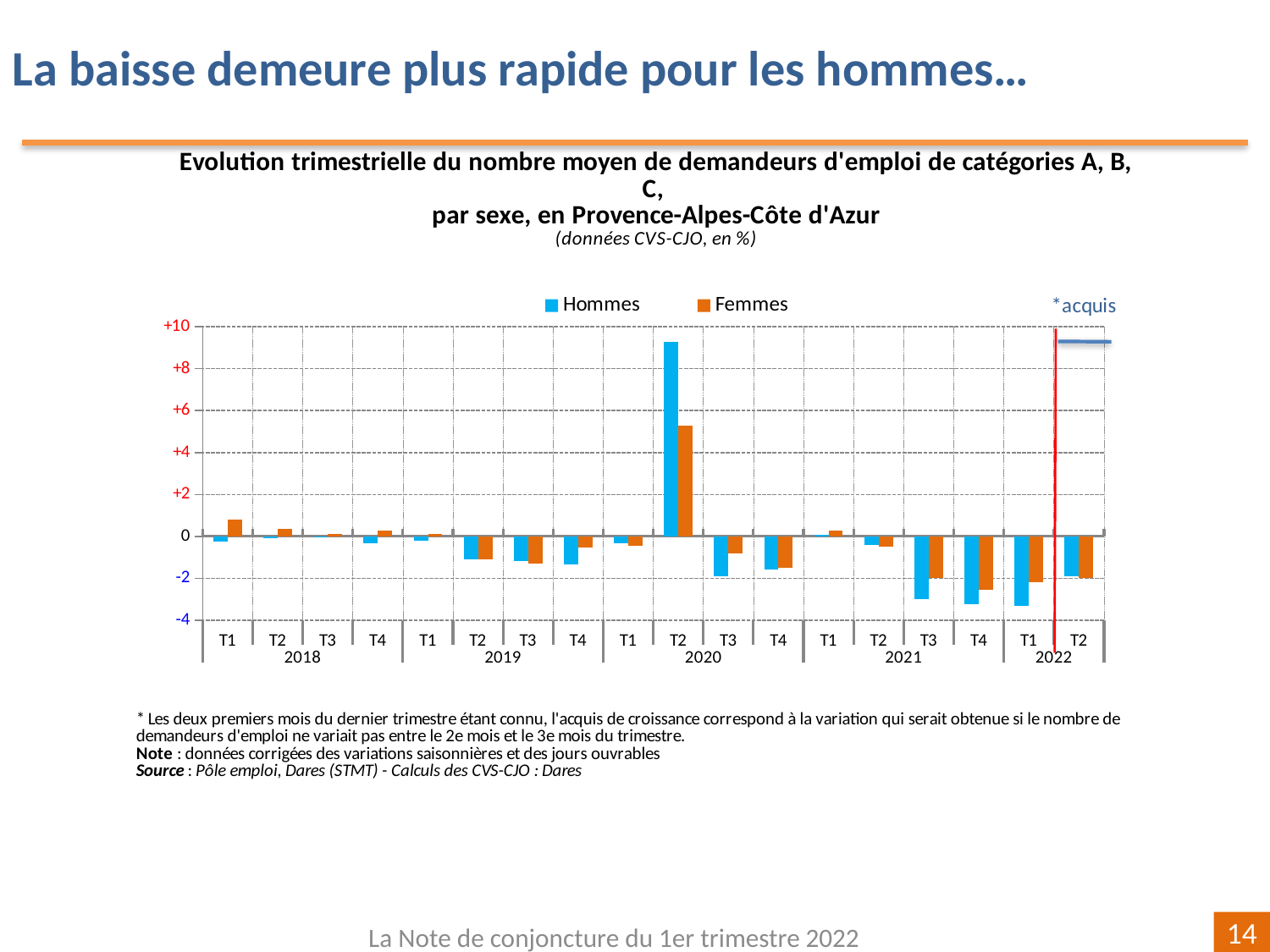
In which quarter does the Femmes series reach its highest value? T2 2020 Is the value for Femmes in T2 2020 greater or less than +4? greater In which quarter does the Hommes series reach its highest value? T2 2020 Which colour represents the Femmes series in the chart? orange How many quarters (categories) are plotted along the x axis? 18 Is the value for Hommes in T2 2020 greater or less than +8? greater How many series does the chart legend list? 2 In T2 2020, which series has the larger value, Hommes or Femmes? Hommes What are the two series named in the chart legend? Hommes and Femmes In T1 2018, which series has the larger value, Hommes or Femmes? Femmes Is the value for Hommes in T3 2021 greater or less than -2? less What kind of chart is shown on the slide? bar chart